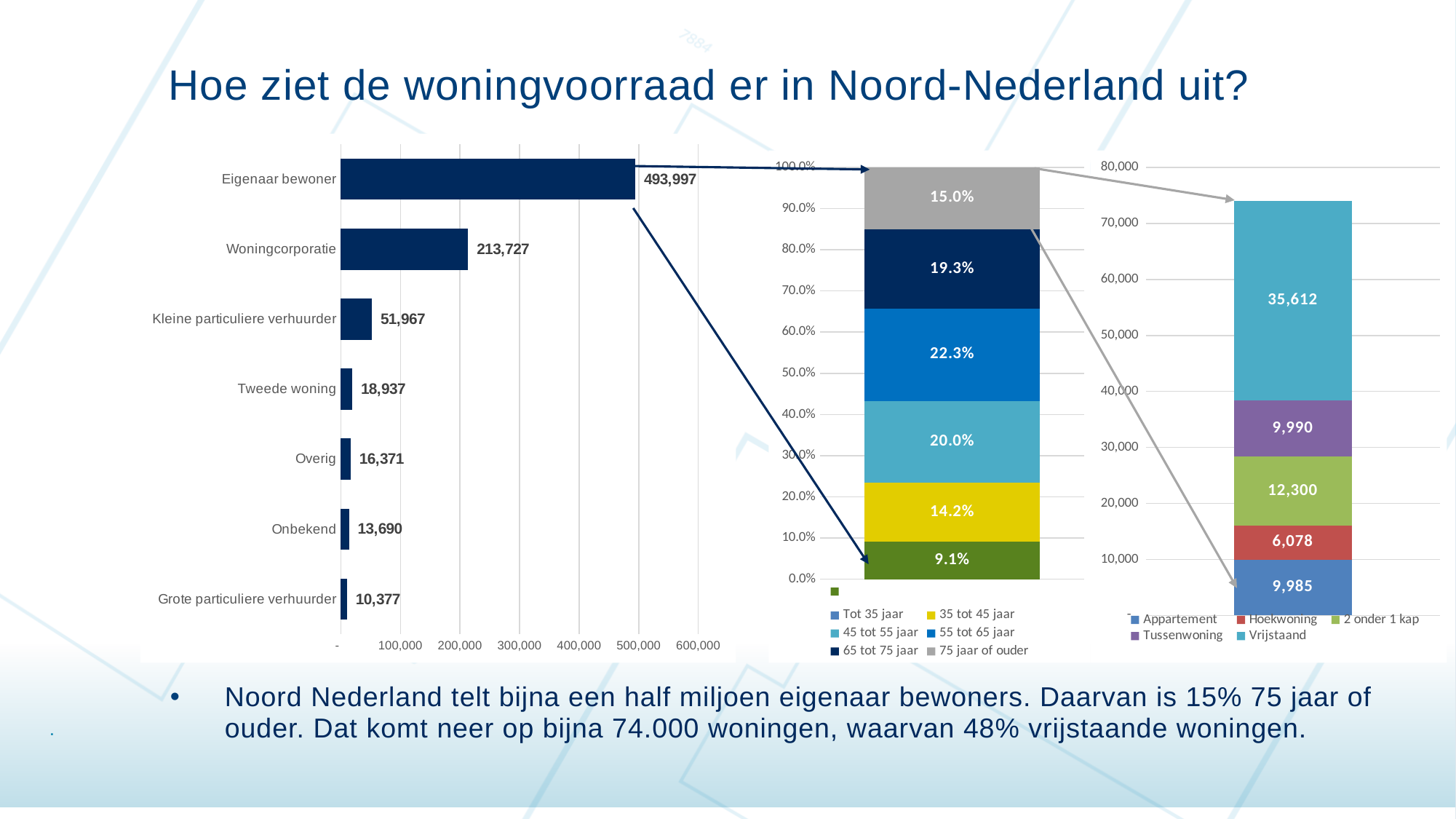
In the right stacked chart, what is the total of the stacked bar? 73,965 In the left bar chart, what is the value for Woningcorporatie? 213,727 In the middle stacked chart, what is the share for 55 tot 65 jaar? 22.3% How many series does the legend of the right stacked chart list? 5 In the left bar chart, which category has the lowest value? Grote particuliere verhuurder What kind of chart is the left chart? Bar chart In the left bar chart, what is the difference between Eigenaar bewoner and Woningcorporatie? 280,270 How many categories does the left bar chart show? 7 In the right stacked chart, what is the value for Vrijstaand? 35,612 In the middle stacked chart, which is larger: 35 tot 45 jaar or 65 tot 75 jaar? 65 tot 75 jaar In the middle stacked chart, what is the share for 75 jaar of ouder? 15.0% In the left bar chart, which category has the highest value? Eigenaar bewoner